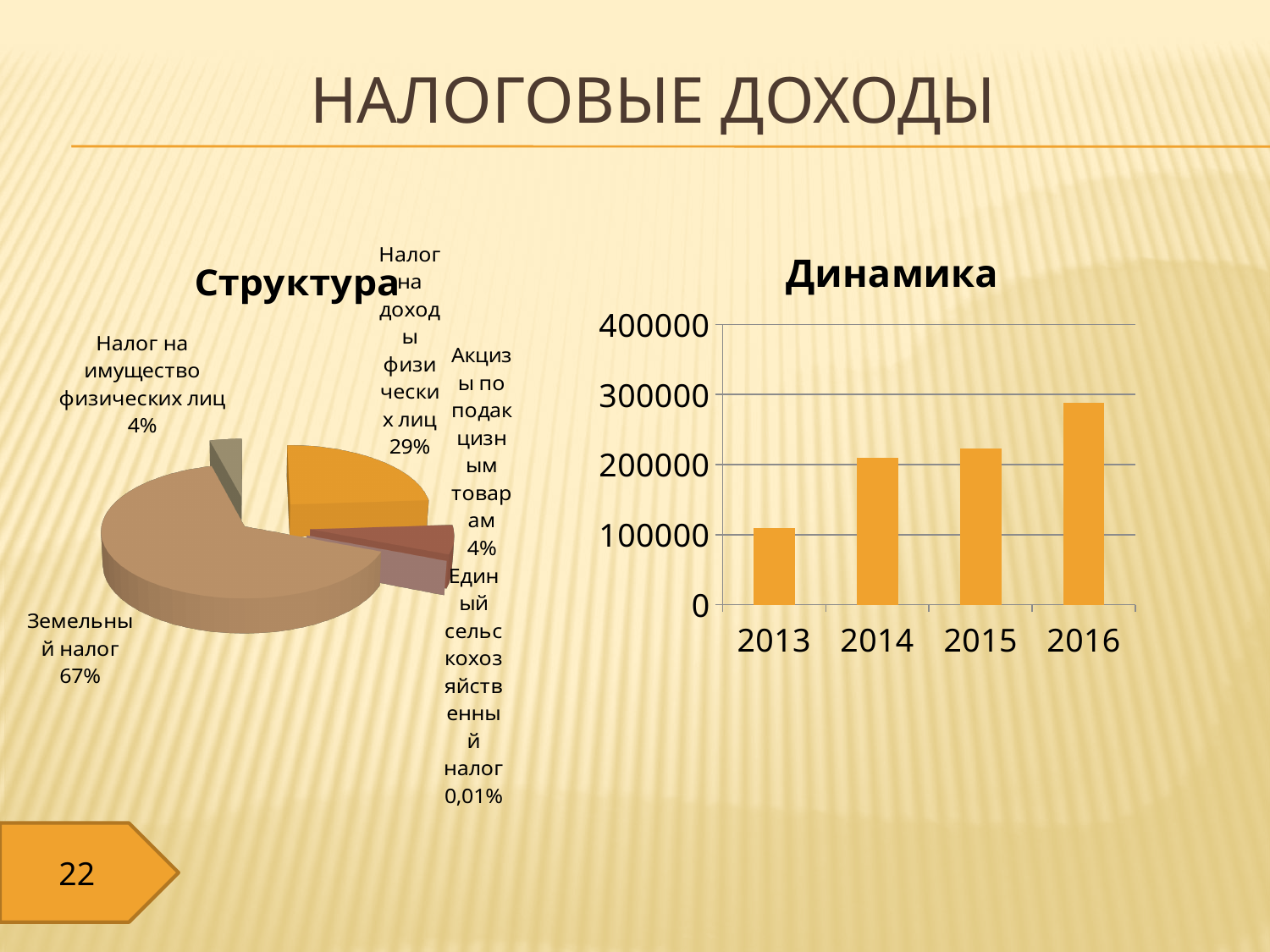
In the "Структура" pie chart, which category has the largest share? Земельный налог In the "Структура" pie chart, which category has the smallest share? Единый сельскохозяйственный налог In the "Динамика" chart, is the value for 2016 greater or less than 200000? greater In the "Динамика" chart, do the values rise or fall from 2013 to 2016? Rise How many slices does the "Структура" pie chart have? 5 How many years are shown in the "Динамика" chart? 4 What kind of chart is the "Структура" chart? Pie chart In the "Структура" pie chart, what share does Единый сельскохозяйственный налог have? 0,01% What kind of chart is the "Динамика" chart? Bar chart In the "Динамика" chart, which year has the lowest value? 2013 In the "Структура" pie chart, what share does Налог на доходы физических лиц have? 29% In the "Структура" pie chart, what share does Земельный налог have? 67%